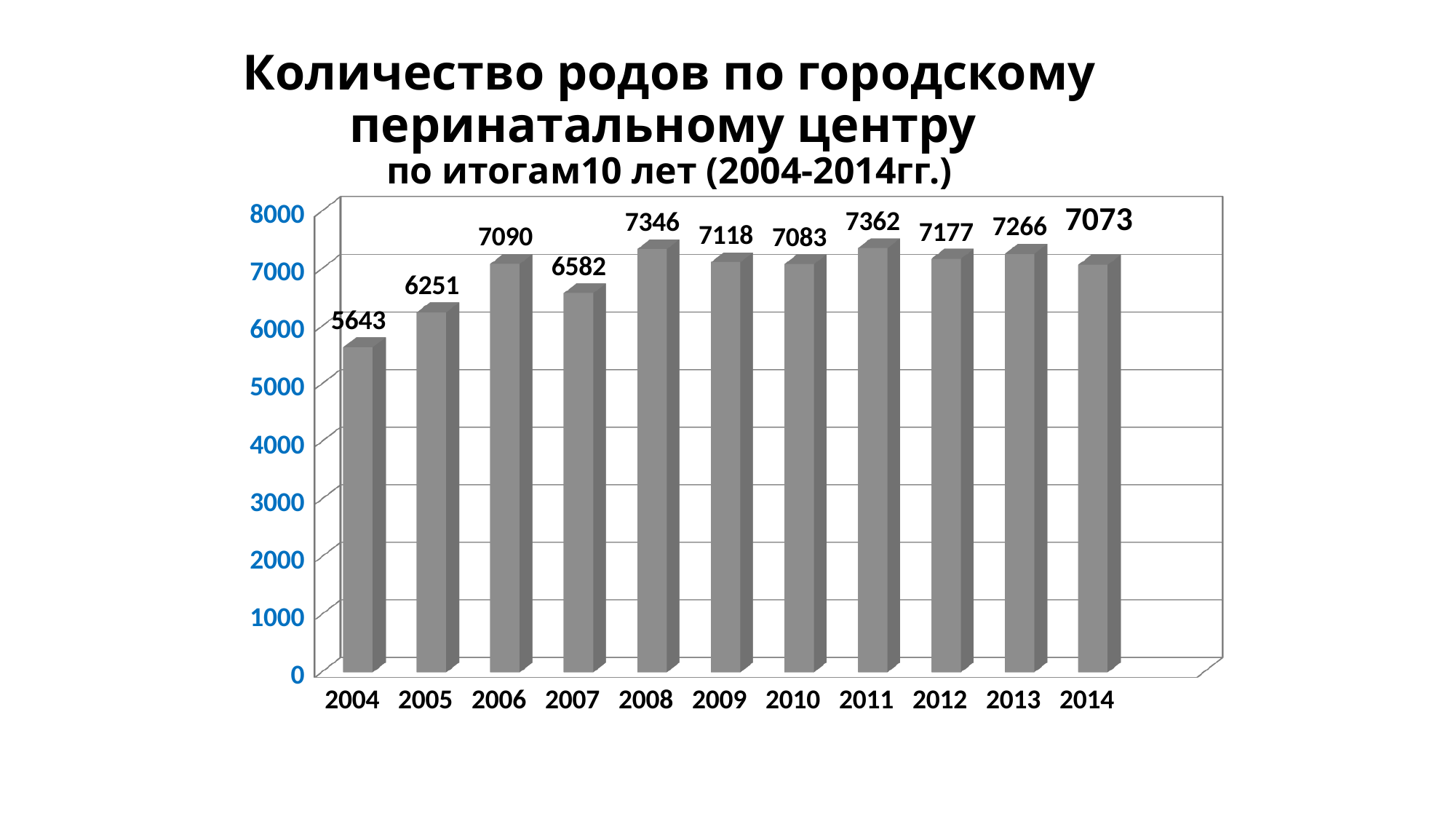
Which is larger, the value for 2006 or the value for 2007? 2006 Which year has the lowest value? 2004 What is the difference between the values for 2005 and 2004? 608 Is the value for 2007 greater or less than 7000? less What is the number of births in 2004? 5643 What kind of chart is shown on the slide? bar chart How many years are shown on the x axis? 11 What is the value shown for 2011? 7362 What is the maximum value shown on the vertical axis? 8000 What is the difference between the values for 2008 and 2007? 764 Which year has the highest value? 2011 What is the value shown for 2014? 7073